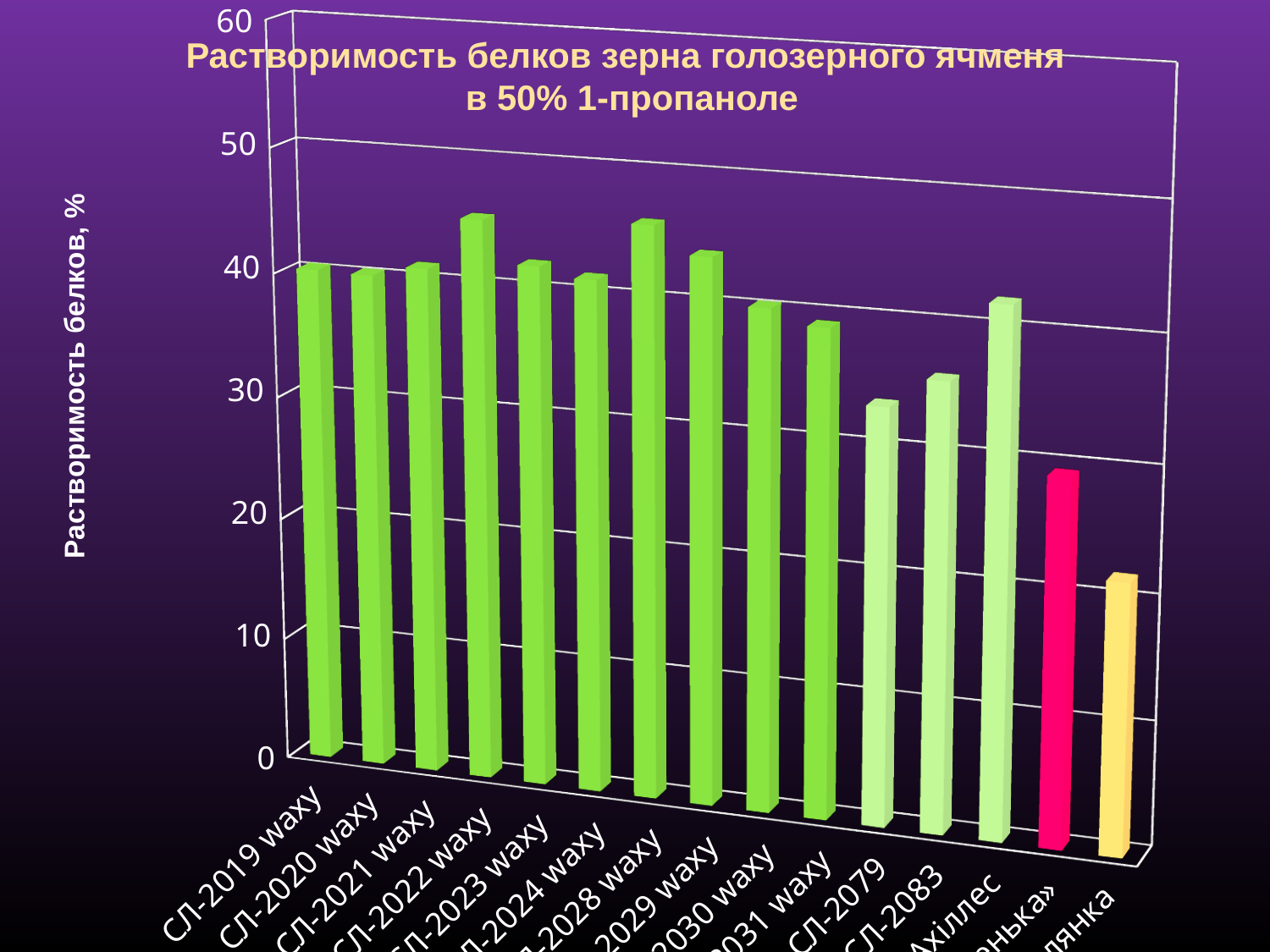
Is the value for СЛ-2031 waxy greater or less than 40? less Is the value for СЛ-2030 waxy greater or less than 30? greater Is the value for СЛ-2079 greater or less than 40? less Which has the larger value, СЛ-2022 waxy or СЛ-2079? СЛ-2022 waxy Which has the larger value, СЛ-2083 or Ахіллес? Ахіллес What kind of chart is shown on the slide? bar chart What is the title of the chart? Растворимость белков зерна голозерного ячменя в 50% 1-пропаноле What is the label of the vertical axis? Растворимость белков, % Which has the larger value, СЛ-2031 waxy or СЛ-2079? СЛ-2031 waxy How many bars (categories) are plotted in the chart? 15